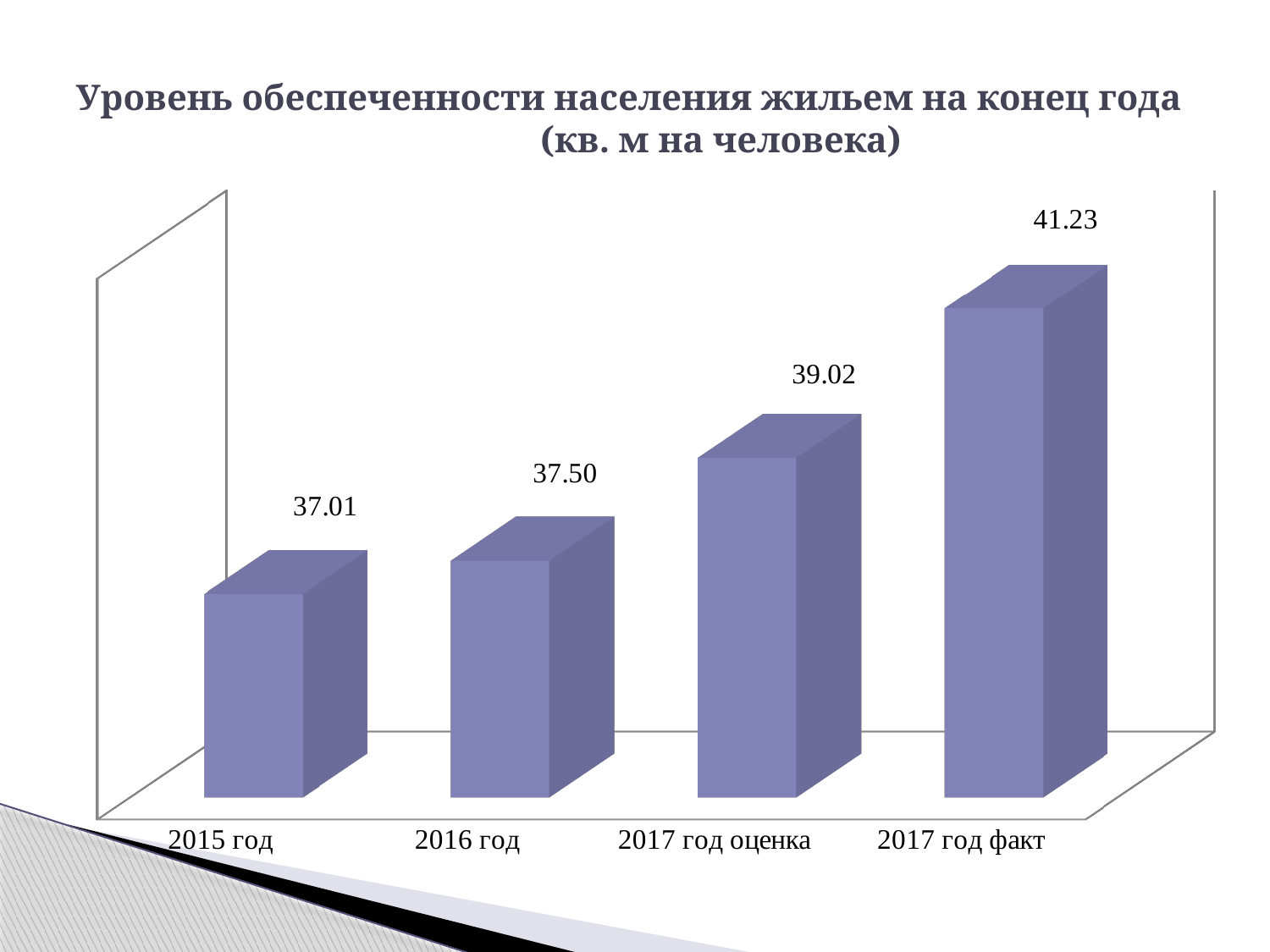
What is the value for 2015 год? 37.01 Do the values rise or fall from 2015 год to 2017 год факт? rise What is the difference between the values for 2016 год and 2015 год? 0.49 What is the value for 2016 год? 37.50 What is the value for 2017 год оценка? 39.02 Which category has the highest value? 2017 год факт What kind of chart is shown on the slide? bar chart Which category has the lowest value? 2015 год How many categories are shown on the chart? 4 What is the difference between the values for 2017 год факт and 2017 год оценка? 2.21 What is the value for 2017 год факт? 41.23 Which is larger, the value for 2017 год оценка or the value for 2016 год? 2017 год оценка